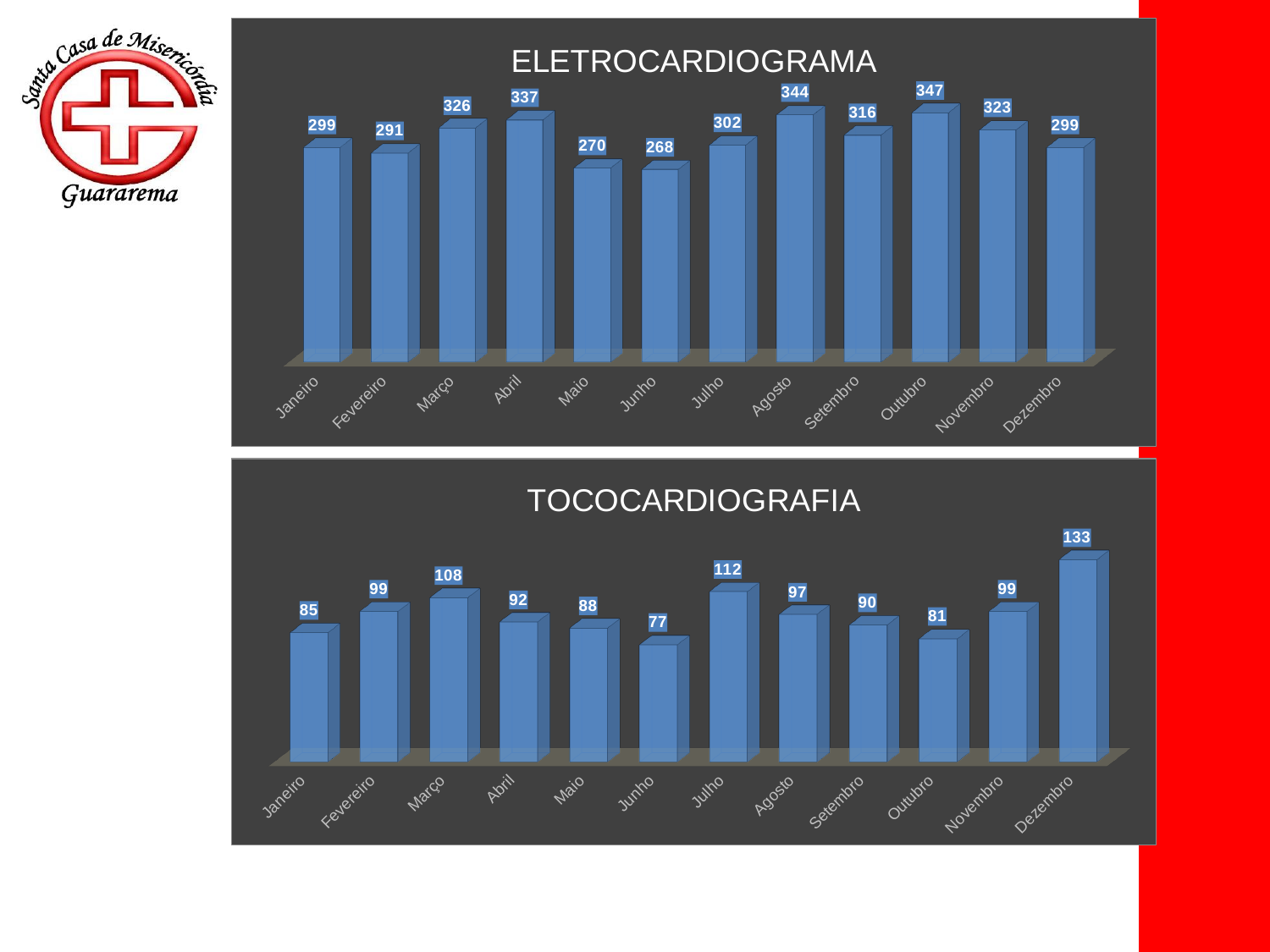
In the TOCOCARDIOGRAFIA chart, which month has the highest value? Dezembro In the ELETROCARDIOGRAMA chart, how many months are plotted? 12 In the ELETROCARDIOGRAMA chart, what is the difference between the values for Outubro and Junho? 79 In the TOCOCARDIOGRAFIA chart, what is the value for Julho? 112 What kind of chart is the TOCOCARDIOGRAFIA chart? Bar chart In the ELETROCARDIOGRAMA chart, which month has the highest value? Outubro What is the title of the top chart on the slide? ELETROCARDIOGRAMA In the TOCOCARDIOGRAFIA chart, what is the difference between the values for Dezembro and Outubro? 52 In the ELETROCARDIOGRAMA chart, what is the value for Abril? 337 In the ELETROCARDIOGRAMA chart, which month has the lowest value? Junho In the ELETROCARDIOGRAMA chart, which is larger, the value for Março or the value for Setembro? Março In the TOCOCARDIOGRAFIA chart, which month has the lowest value? Junho